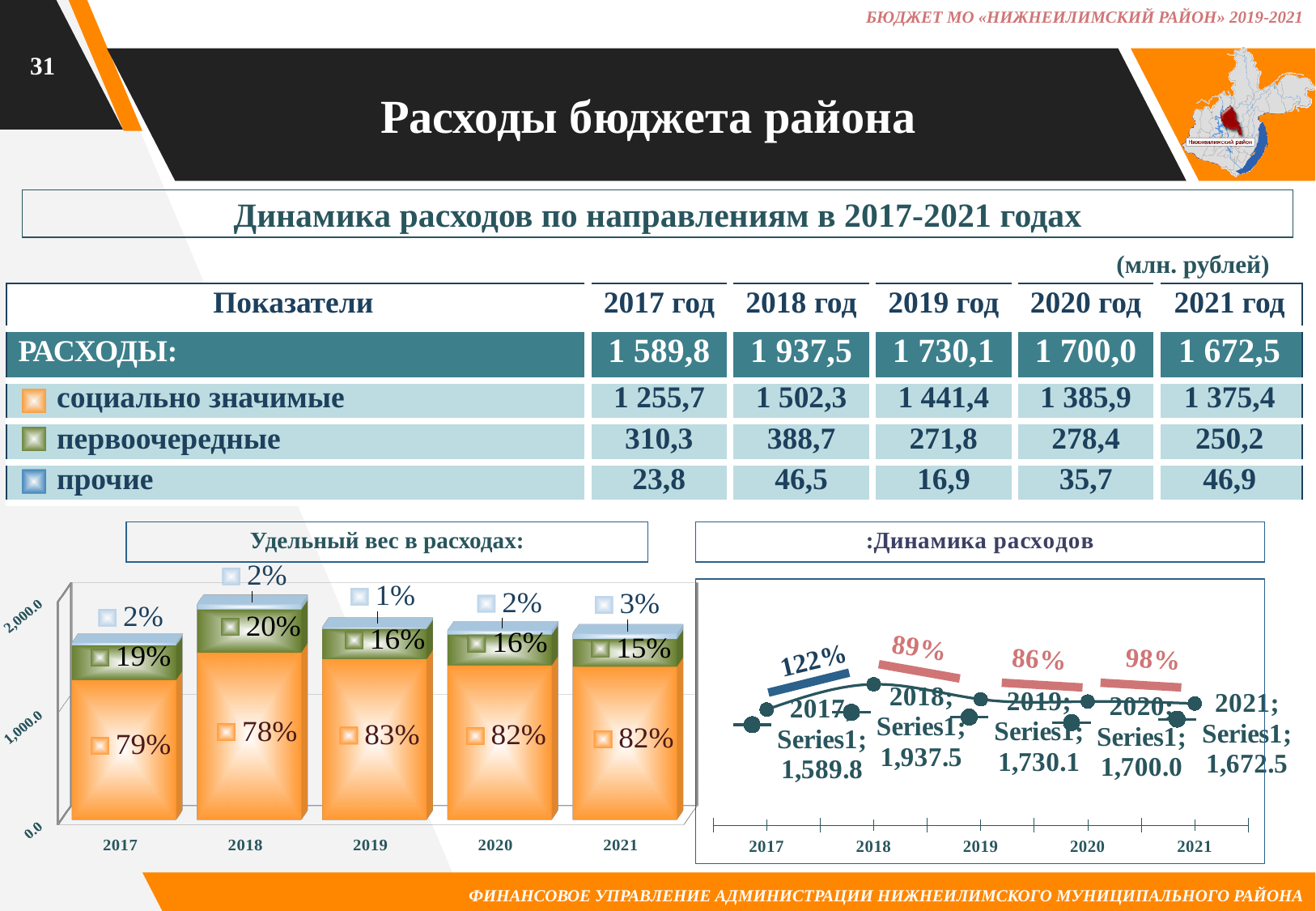
In the left chart "Удельный вес в расходах:", what is the value of the orange segment for 2019? 83% In the left chart "Удельный вес в расходах:", how many years are shown on the x axis? 5 What kind of chart is the left chart titled "Удельный вес в расходах:"? bar chart In the left chart "Удельный вес в расходах:", which year has the lowest green segment value? 2021 In the right chart "Динамика расходов", what is the value for 2018? 1,937.5 What kind of chart is the right chart titled "Динамика расходов"? line chart In the left chart "Удельный вес в расходах:", what is the value of the green segment for 2018? 20% In the right chart "Динамика расходов", do the values rise or fall from 2018 to 2021? fall In the left chart "Удельный вес в расходах:", what is the value of the blue segment for 2021? 3% In the right chart "Динамика расходов", what is the difference between the 2018 value and the 2017 value? 347.7 In the left chart "Удельный вес в расходах:", which year has the highest orange segment value? 2019 In the right chart "Динамика расходов", which year has the lowest value? 2017